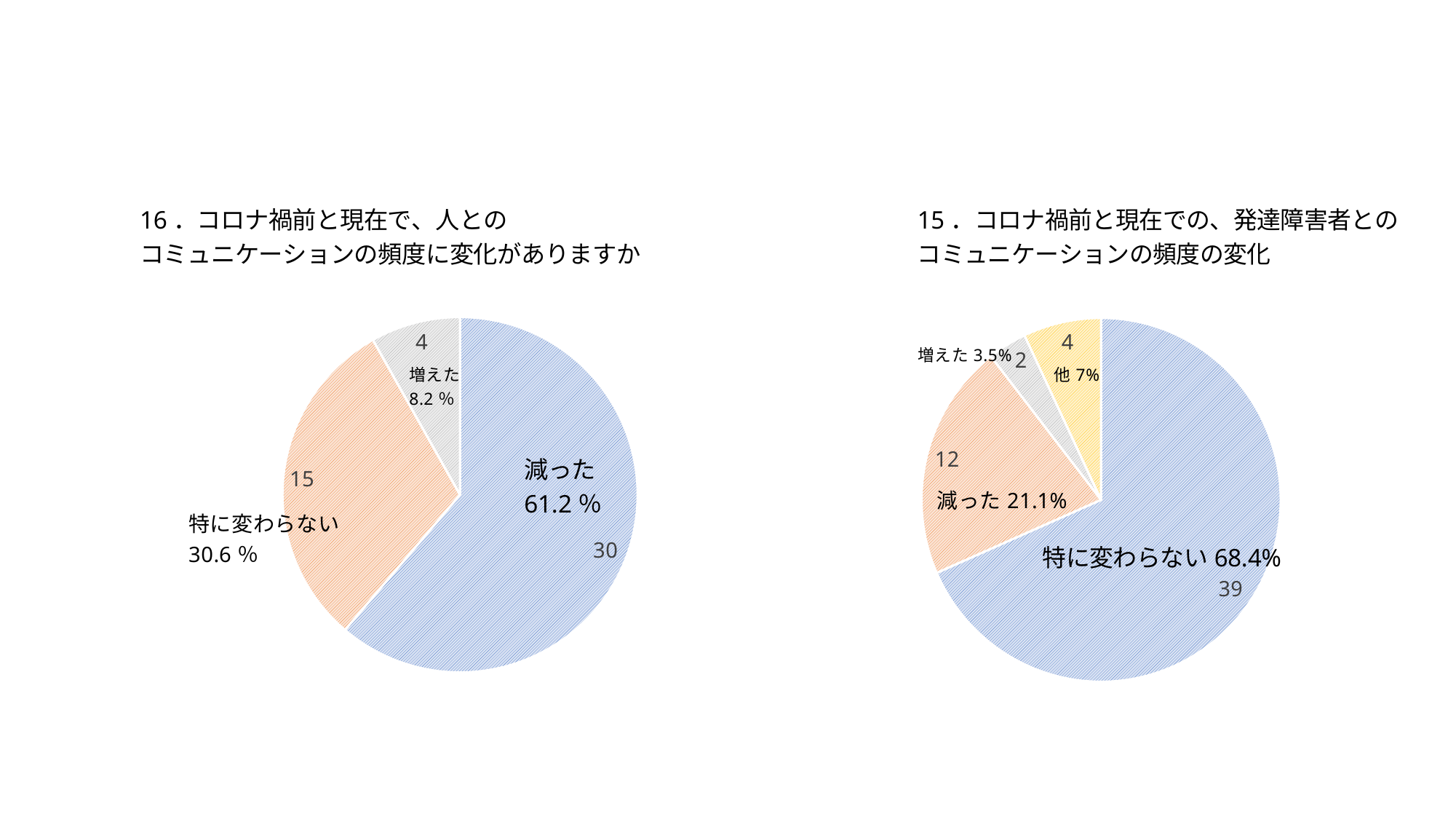
In the right pie chart (question 15), what count is shown for 減った? 12 In the right pie chart (question 15), what percentage is shown for 特に変わらない? 68.4% In the right pie chart (question 15), which is larger, the slice for 減った or the slice for 他? 減った In the left pie chart (question 16), how many slices does the pie have? 3 In the left pie chart (question 16), what is the difference between the counts for 減った and 特に変わらない? 15 In the right pie chart (question 15), which category has the smallest slice? 増えた In the left pie chart (question 16), which category has the smallest slice? 増えた In the left pie chart (question 16), what percentage is shown for 減った? 61.2 % In the right pie chart (question 15), which category has the largest slice? 特に変わらない In the right pie chart (question 15), how many slices does the pie have? 4 In the left pie chart (question 16), what count is shown for 特に変わらない? 15 What type of chart is used on this slide? Pie chart